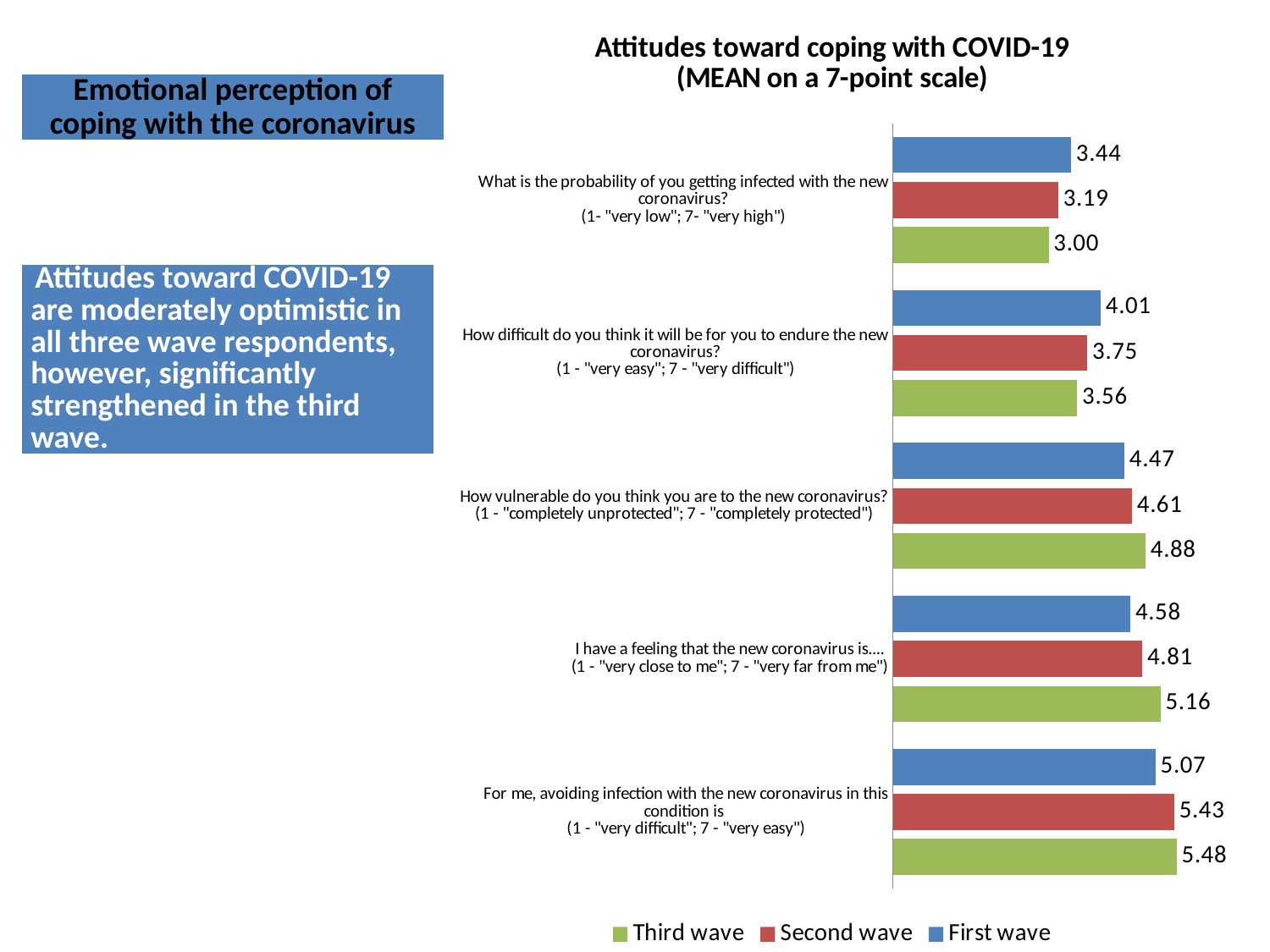
Which question has the lowest Second wave mean? What is the probability of you getting infected with the new coronavirus? How many questions (categories) are shown in the chart? 5 What is the Third wave mean for "For me, avoiding infection with the new coronavirus in this condition is"? 5.48 For "How difficult do you think it will be for you to endure the new coronavirus?", which is larger: the First wave mean or the Second wave mean? First wave What is the Second wave mean for "How vulnerable do you think you are to the new coronavirus?" 4.61 What is the difference between the Third wave and First wave means for "I have a feeling that the new coronavirus is...."? 0.58 What is the First wave mean for "What is the probability of you getting infected with the new coronavirus?" 3.44 Which colour represents the Second wave in the chart? Red Which question has the highest Third wave mean? For me, avoiding infection with the new coronavirus in this condition is How many series does the legend list? 3 What kind of chart is shown on the slide? Bar chart What is the Third wave mean for "How difficult do you think it will be for you to endure the new coronavirus?" 3.56